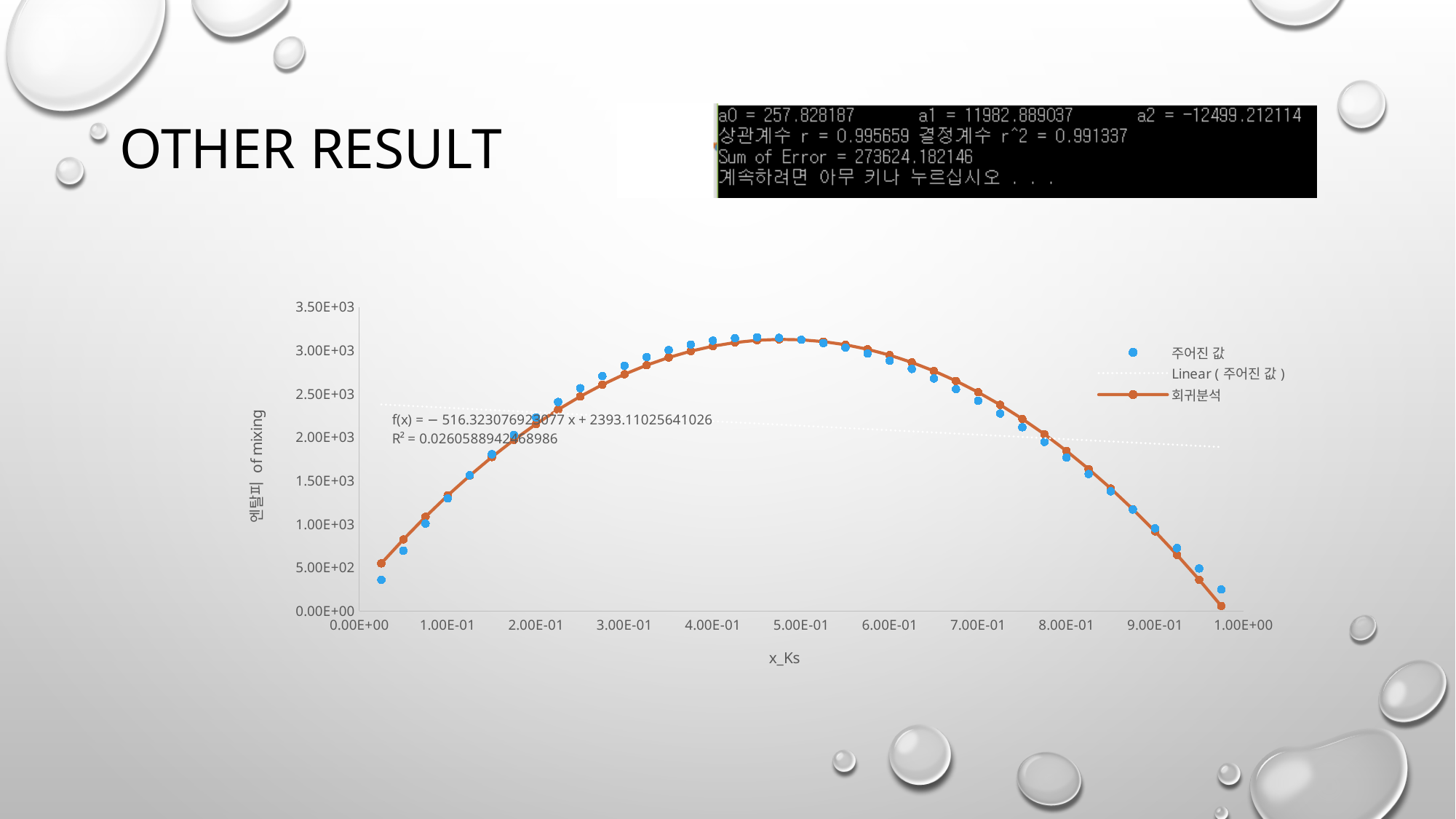
Is the value of the 회귀분석 series at x = 3.00E-01 greater or less than 2.00E+03? greater Is the value of the 주어진 값 series at x = 8.00E-01 greater or less than 2.50E+03? less Is the value of the 주어진 값 series at x = 9.00E-01 greater or less than 1.50E+03? less How do the plotted values change as x_Ks increases from 0 to 1? They rise to a peak near the middle, then fall What are the three legend entries? 주어진 값, Linear ( 주어진 값 ), 회귀분석 What kind of chart is shown on the slide? scatter chart What is the title of the x axis? x_Ks How many series does the legend list? 3